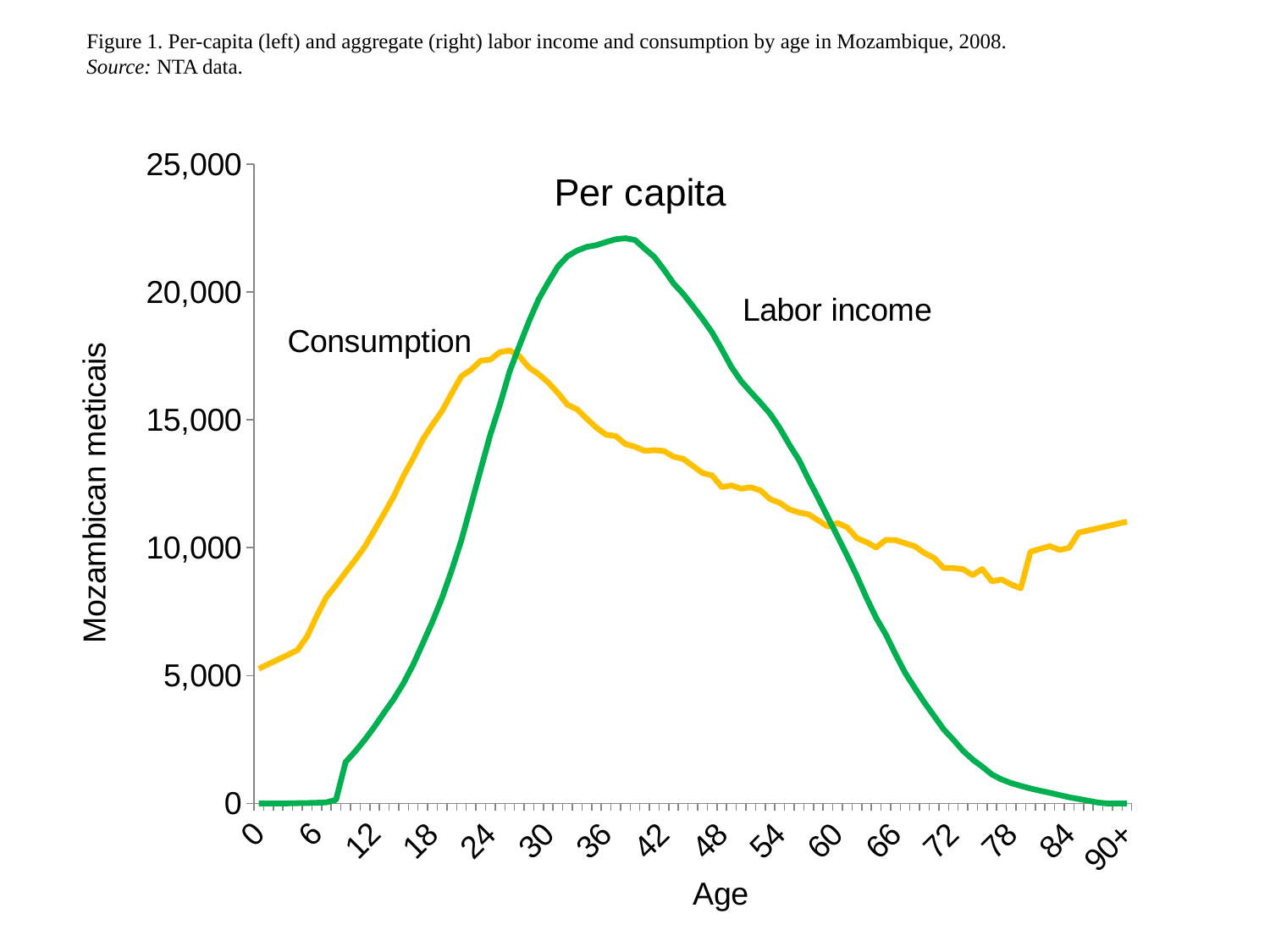
What is the label on the vertical axis of the chart? Mozambican meticais At age 36, which series has the higher value, Labor income or Consumption? Labor income Is the value of Labor income at age 36 greater or less than 20,000? greater What kind of chart is shown on the slide? line chart Is the value of Consumption at age 24 greater or less than 15,000? greater Is the value of Labor income at age 6 greater or less than 5,000? less What is the label on the horizontal axis of the chart? Age Does the Labor income line rise or fall between age 42 and age 90+? fall At age 12, which series has the higher value, Labor income or Consumption? Consumption How many series are plotted on the chart? 2